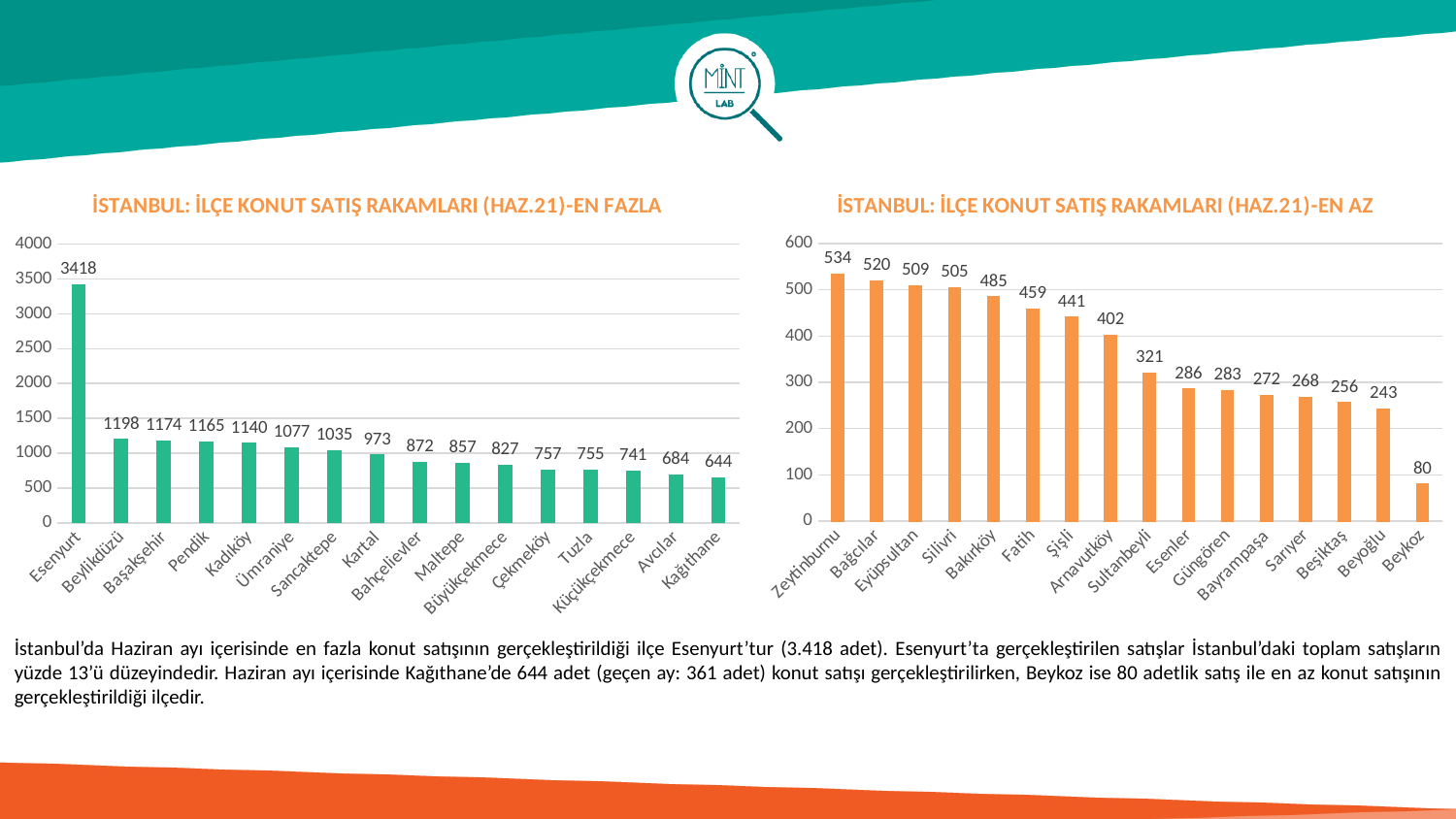
In the 'EN FAZLA' chart on the left, which district has the lowest value? Kağıthane In the 'EN AZ' chart on the right, do the values rise or fall from left to right? fall In the 'EN FAZLA' chart on the left, what is the value for Esenyurt? 3418 In the 'EN AZ' chart on the right, what is the difference between Sultanbeyli and Esenler? 35 What type of chart is the 'EN AZ' chart on the right? bar chart In the 'EN AZ' chart on the right, what is the value for Beykoz? 80 In the 'EN FAZLA' chart on the left, is the value for Pendik greater or less than 1000? greater In the 'EN AZ' chart on the right, which district has the highest value? Zeytinburnu In the 'EN AZ' chart on the right, which is larger, Fatih or Şişli? Fatih In the 'EN FAZLA' chart on the left, how many districts are shown? 16 In the 'EN FAZLA' chart on the left, what is the value for Kartal? 973 In the 'EN FAZLA' chart on the left, what is the difference between Esenyurt and Beylikdüzü? 2220